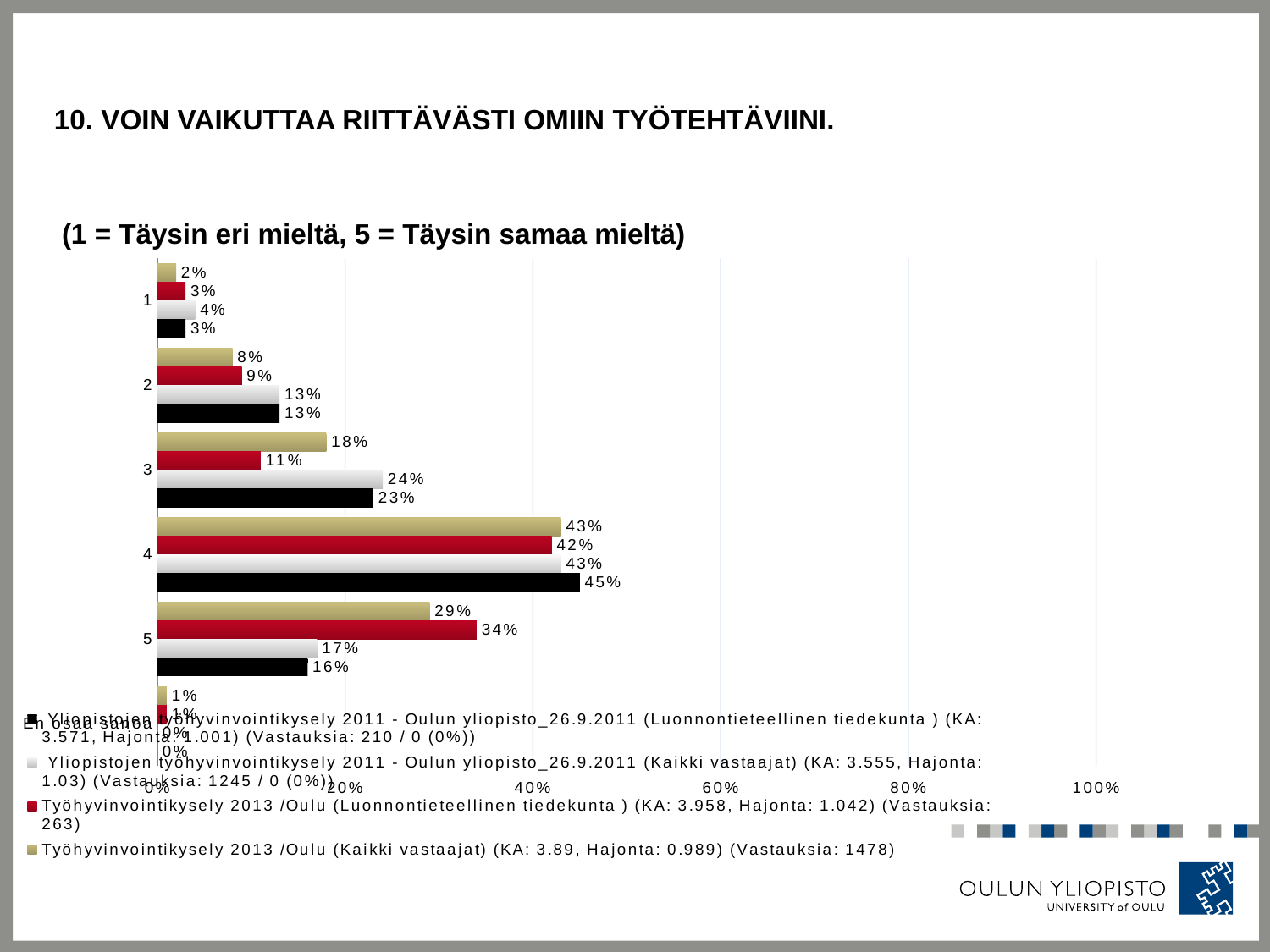
What is the value for category 4 in the Työhyvinvointikysely 2013 /Oulu (Kaikki vastaajat) series? 43% Which category has the highest value in the Työhyvinvointikysely 2013 /Oulu (Luonnontieteellinen tiedekunta) series? 4 How many series does the legend list? 4 What is the difference between the Työhyvinvointikysely 2013 /Oulu (Luonnontieteellinen tiedekunta) value and the Yliopistojen työhyvinvointikysely 2011 (Luonnontieteellinen tiedekunta) value for category 5? 18% Which of categories 1 to 5 has the lowest value in the Työhyvinvointikysely 2013 /Oulu (Kaikki vastaajat) series? 1 What is the value for category 3 in the Yliopistojen työhyvinvointikysely 2011 (Kaikki vastaajat) series? 24% What is the value for category 5 in the Työhyvinvointikysely 2013 /Oulu (Luonnontieteellinen tiedekunta) series? 34% What kind of chart is shown on the slide? bar chart Is the value for category 4 in the Yliopistojen työhyvinvointikysely 2011 (Luonnontieteellinen tiedekunta) series greater or less than 40%? greater What is the title of the slide? 10. VOIN VAIKUTTAA RIITTÄVÄSTI OMIIN TYÖTEHTÄVIINI. What is the value for category 2 in the Yliopistojen työhyvinvointikysely 2011 (Luonnontieteellinen tiedekunta) series? 13% For category 3, which is larger: the Yliopistojen työhyvinvointikysely 2011 (Kaikki vastaajat) value or the Työhyvinvointikysely 2013 /Oulu (Kaikki vastaajat) value? Yliopistojen työhyvinvointikysely 2011 (Kaikki vastaajat)